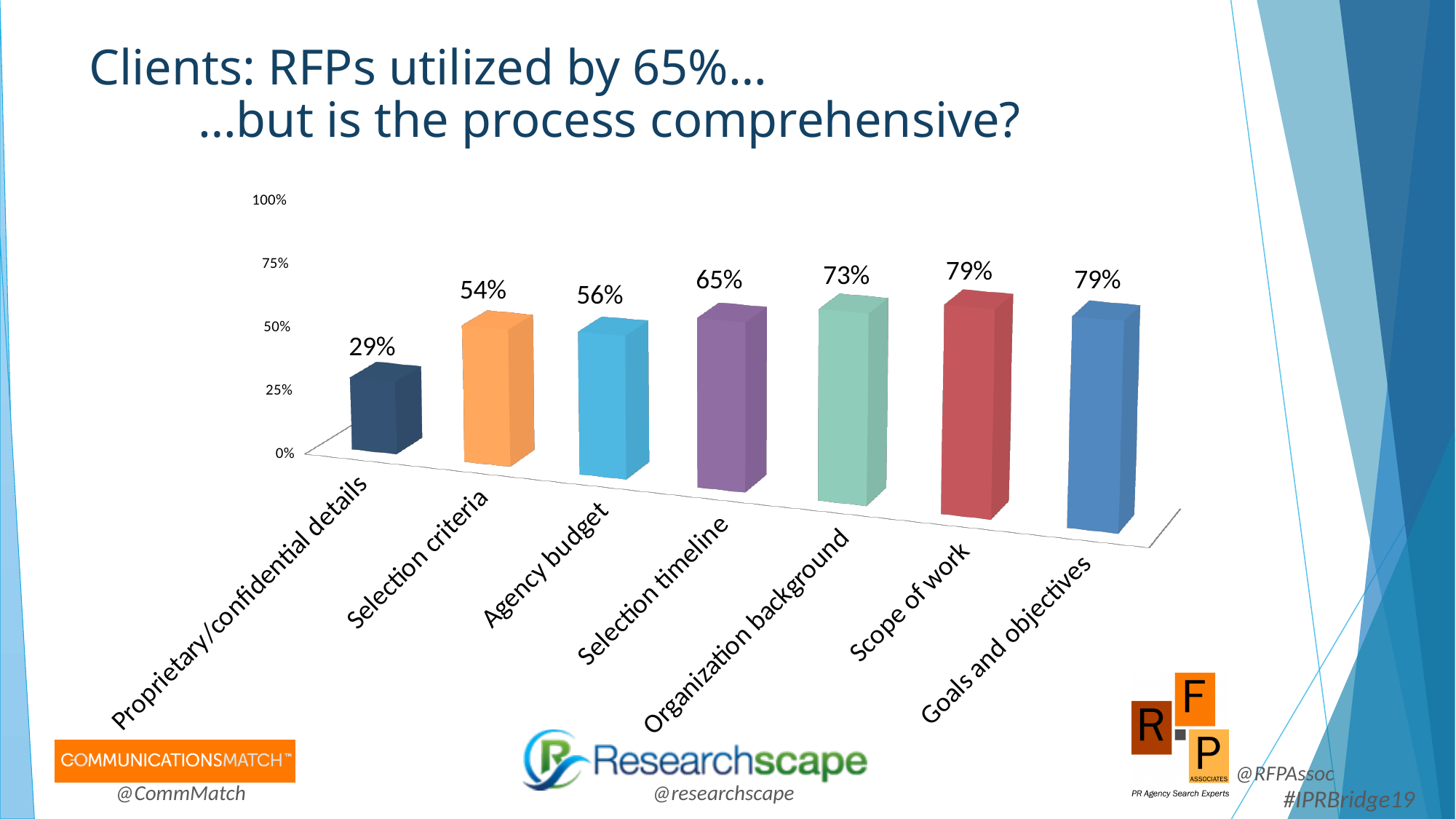
What is the value for Organization background? 73% What is the value for Agency budget? 56% What is the highest value shown on the vertical axis? 100% What is the value for Selection criteria? 54% Is the value for Selection timeline greater or less than 50%? greater Which category has the lowest value? Proprietary/confidential details What is the value for Proprietary/confidential details? 29% Which is larger, the value for Organization background or the value for Agency budget? Organization background What is the difference between the values for Scope of work and Selection timeline? 14% Do the values generally rise or fall from left to right along the x axis? rise What kind of chart is shown on the slide? bar chart How many categories are shown in the chart? 7